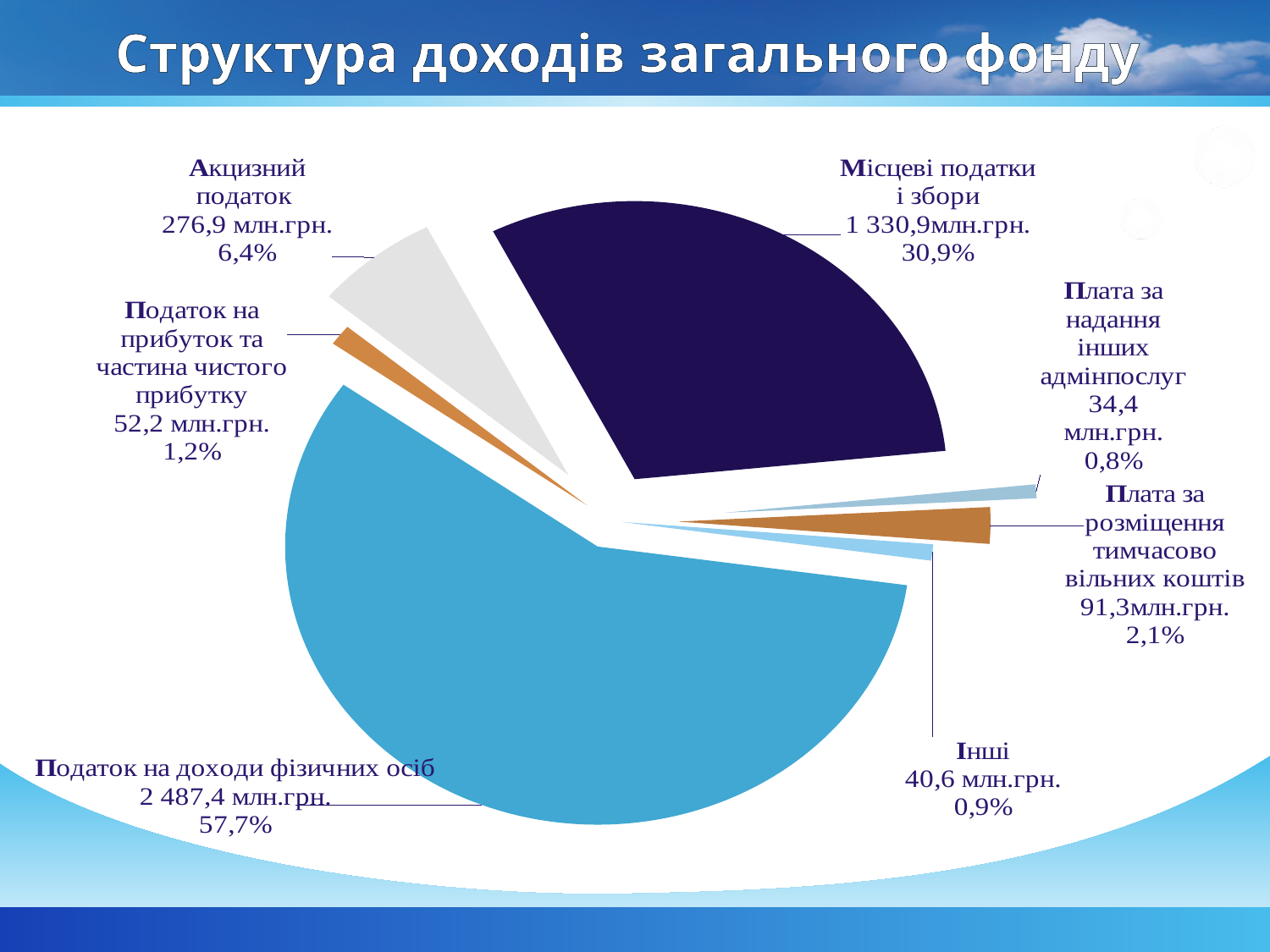
What share of the pie is Податок на доходи фізичних осіб? 57,7% Which is larger: Акцизний податок or Інші? Акцизний податок What is the title of the chart? Структура доходів загального фонду Which category has the largest slice of the pie? Податок на доходи фізичних осіб What kind of chart is shown on the slide? pie chart What share of the pie is Плата за розміщення тимчасово вільних коштів? 2,1% Which category has the smallest slice of the pie? Плата за надання інших адмінпослуг What is the value shown for Інші? 40,6 млн.грн. What is the difference in percentage share between Податок на доходи фізичних осіб and Місцеві податки і збори? 26,8% What is the value shown for Місцеві податки і збори? 1 330,9 млн.грн. What is the value shown for Акцизний податок? 276,9 млн.грн. How many slices does the pie chart have? 7